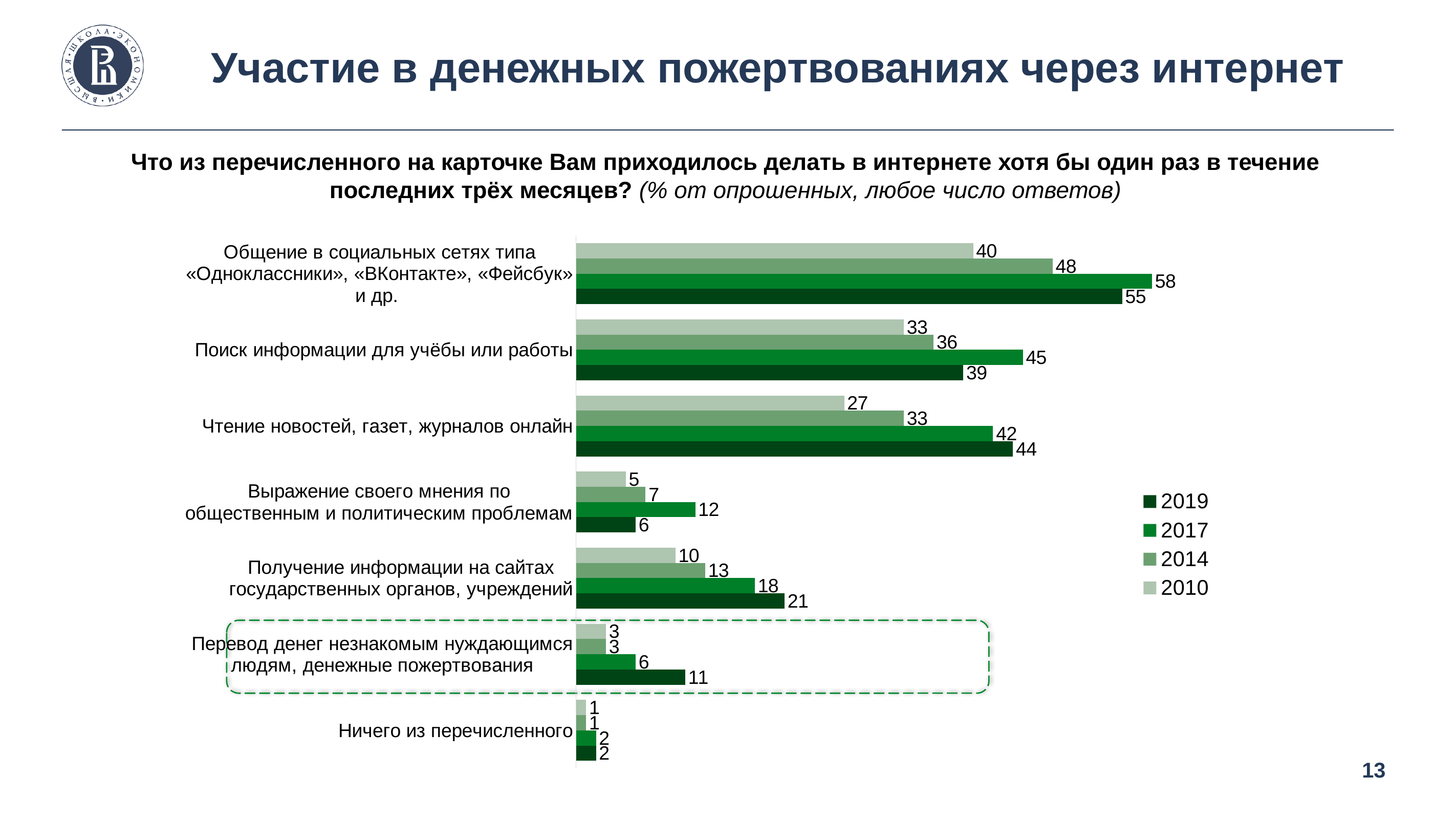
What is the 2019 value for «Перевод денег незнакомым нуждающимся людям, денежные пожертвования»? 11 For «Чтение новостей, газет, журналов онлайн», which is larger: the 2019 value or the 2017 value? 2019 How does the value for «Перевод денег незнакомым нуждающимся людям, денежные пожертвования» change from 2010 to 2019? rises Which category has the highest 2019 value? Общение в социальных сетях типа «Одноклассники», «ВКонтакте», «Фейсбук» и др. How many categories are shown on the chart? 7 What is the difference between the 2019 and 2010 values for «Получение информации на сайтах государственных органов, учреждений»? 11 Which category has the lowest 2017 value? Ничего из перечисленного What kind of chart is shown on the slide? bar chart How many series does the legend list? 4 Which category on the chart is highlighted with a dashed outline? Перевод денег незнакомым нуждающимся людям, денежные пожертвования What is the 2010 value for «Общение в социальных сетях типа «Одноклассники», «ВКонтакте», «Фейсбук» и др.»? 40 What is the 2017 value for «Поиск информации для учёбы или работы»? 45